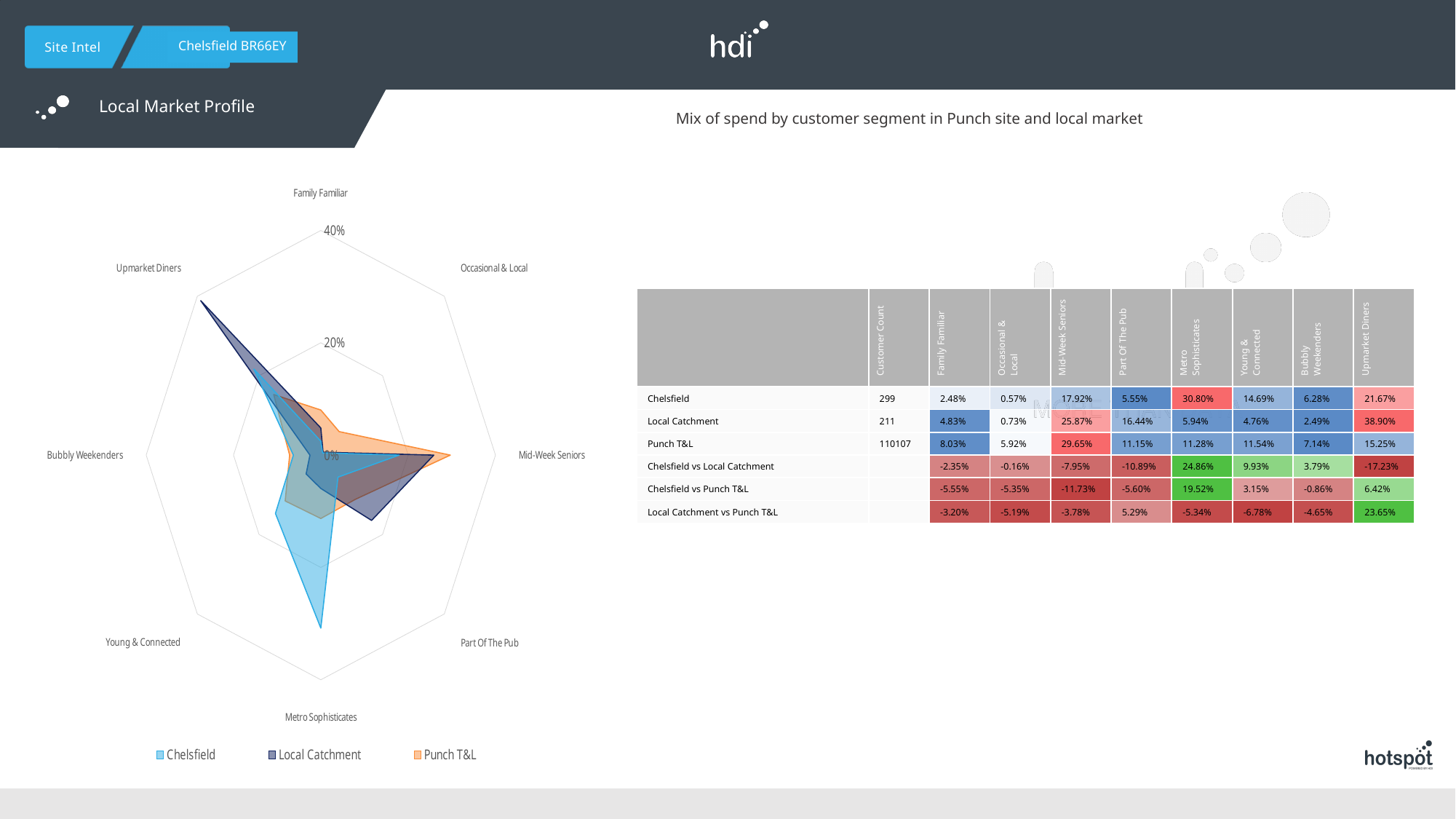
How many series does the radar chart's legend list? 3 Which customer segment has the highest value for Chelsfield on the radar chart? Metro Sophisticates Which customer segment has the highest value for Local Catchment on the radar chart? Upmarket Diners What is the highest percentage tick shown on the radar chart's axis? 40% What is the Local Catchment value for Upmarket Diners? 38.90% What is the difference between the Chelsfield and Local Catchment values for Metro Sophisticates? 24.86% How many customer segments are plotted around the radar chart? 8 Which customer segment has the highest value for Punch T&L on the radar chart? Mid-Week Seniors What is the Chelsfield value for Metro Sophisticates? 30.80% For Young & Connected, which is larger: Chelsfield or Local Catchment? Chelsfield What kind of chart is shown on the left of the slide? Radar chart Is the Chelsfield value for Metro Sophisticates greater or less than 20%? greater